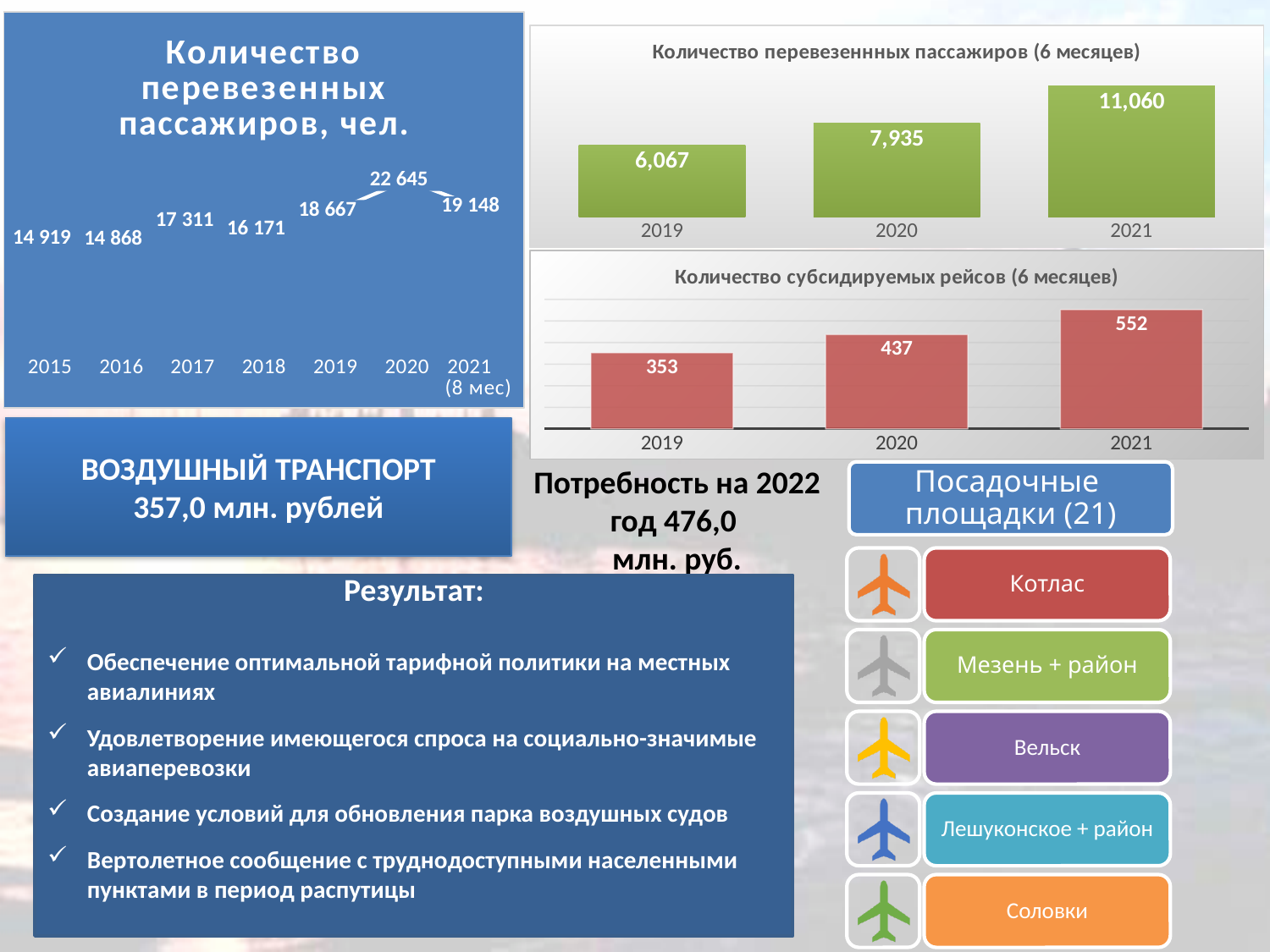
In the chart titled "Количество перевезенннных пассажиров (6 месяцев)", what is the difference between the 2021 and 2019 values? 4,993 In the chart titled "Количество перевезенных пассажиров, чел.", which year has the lowest value? 2016 In the chart titled "Количество перевезенных пассажиров, чел.", how many years are plotted? 7 In the chart titled "Количество перевезенных пассажиров, чел.", what is the value for 2017? 17 311 In the chart titled "Количество субсидируемых рейсов (6 месяцев)", what is the value for 2019? 353 In the chart titled "Количество перевезенных пассажиров, чел.", what is the difference between the 2020 and 2021 (8 мес) values? 3 497 In the chart titled "Количество перевезенннных пассажиров (6 месяцев)", what type of chart is shown? bar chart In the chart titled "Количество перевезенных пассажиров, чел.", which year has the highest value? 2020 In the chart titled "Количество субсидируемых рейсов (6 месяцев)", which year has the highest value? 2021 In the chart titled "Количество перевезенннных пассажиров (6 месяцев)", what is the value for 2020? 7,935 In the chart titled "Количество субсидируемых рейсов (6 месяцев)", what is the difference between the 2021 and 2020 values? 115 In the chart titled "Количество перевезенннных пассажиров (6 месяцев)", do the values rise or fall from 2019 to 2021? rise